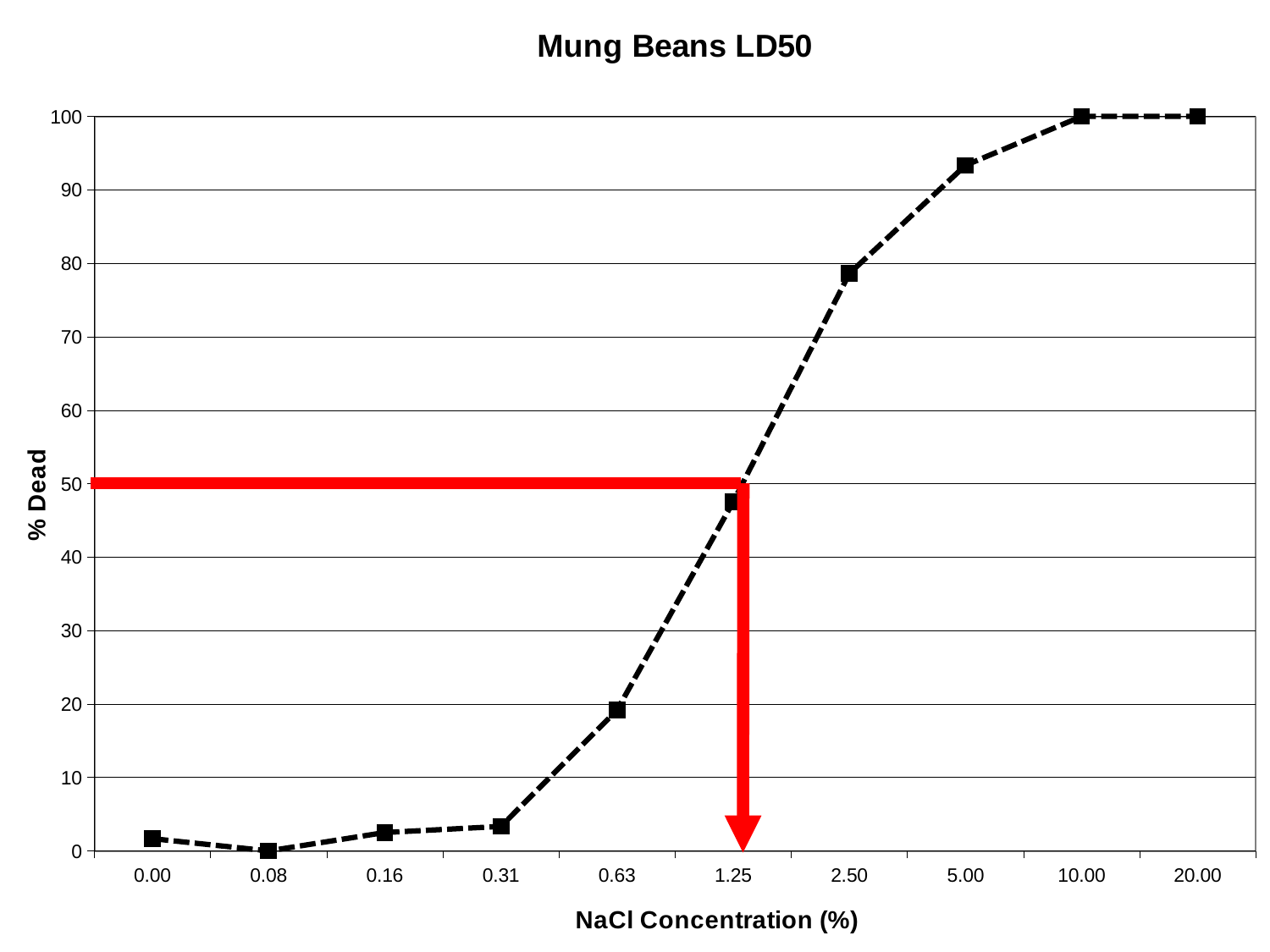
What type of chart is shown on the slide? line chart Is the % Dead value at an NaCl concentration of 2.50 greater or less than 70? greater Do the % Dead values generally rise or fall as NaCl concentration increases along the x axis? rise What is the title of the chart? Mung Beans LD50 How many data points are plotted on the chart? 10 Is the % Dead value at an NaCl concentration of 1.25 greater or less than 50? less Which has a higher % Dead value: NaCl concentration 0.63 or 2.50? 2.50 What is the label of the y axis? % Dead What is the % Dead value at an NaCl concentration of 20.00? 100 What is the % Dead value at an NaCl concentration of 10.00? 100 Is the % Dead value at an NaCl concentration of 5.00 greater or less than 90? greater What is the % Dead value at an NaCl concentration of 0.08? 0